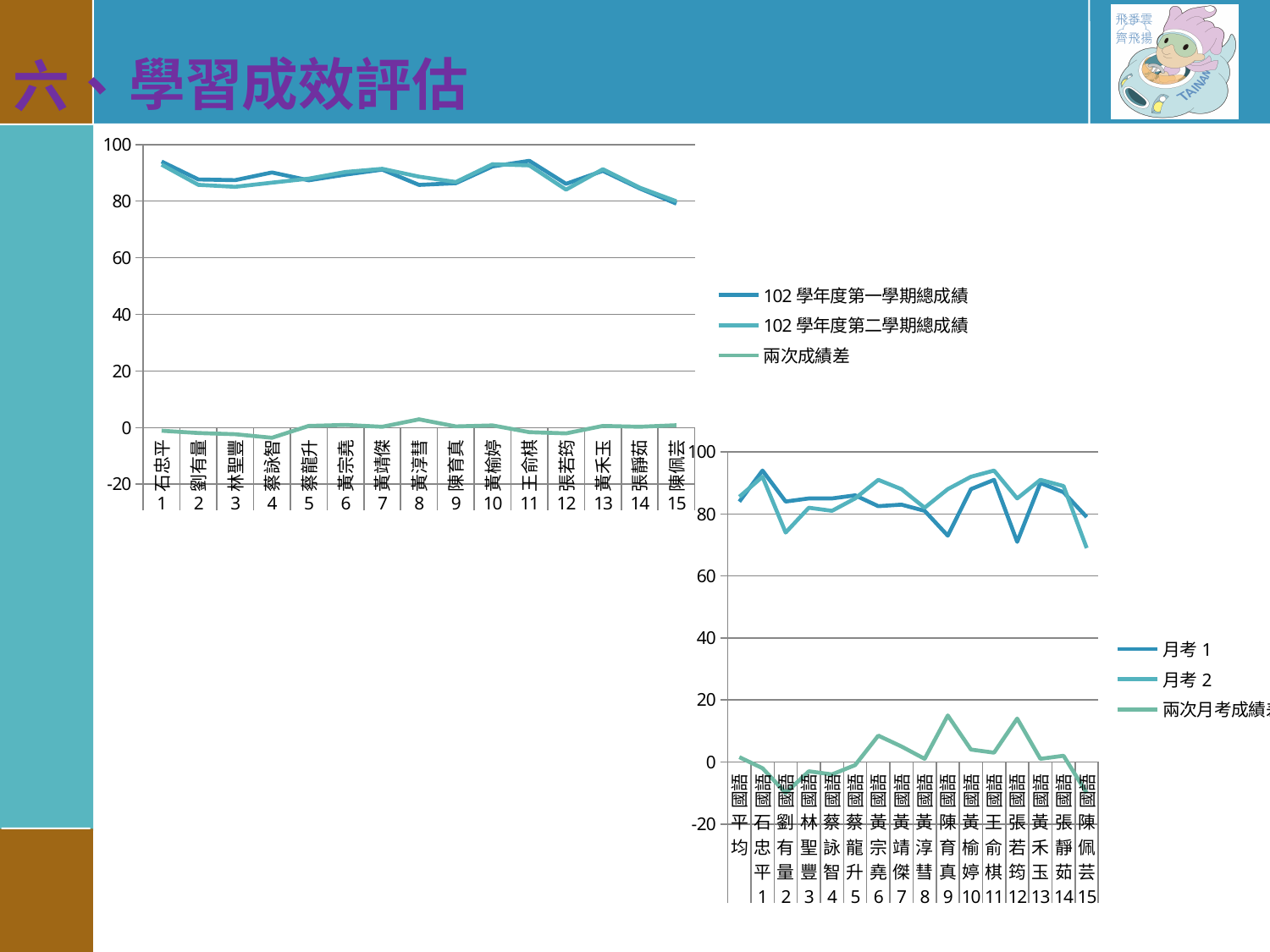
In the left chart, is the 102 學年度第一學期總成績 value for 石忠平 greater or less than 80? greater How many categories are plotted along the x axis of the right chart (including 平均)? 16 How many students (categories) are plotted along the x axis of the left chart? 15 In the left chart, is the 兩次成績差 value for 黃淳彗 greater or less than 20? less In the left chart, is the 102 學年度第二學期總成績 value for 陳佩芸 greater or less than 90? less In the right chart, which is larger for 陳佩芸: 月考 1 or 月考 2? 月考 1 How many series does the legend of the right chart list? 3 What kind of chart is the chart on the left of the slide? line chart What kind of chart is the chart on the right of the slide? line chart How many series does the legend of the left chart list? 3 In the right chart, which is larger for 張若筠: 月考 1 or 月考 2? 月考 2